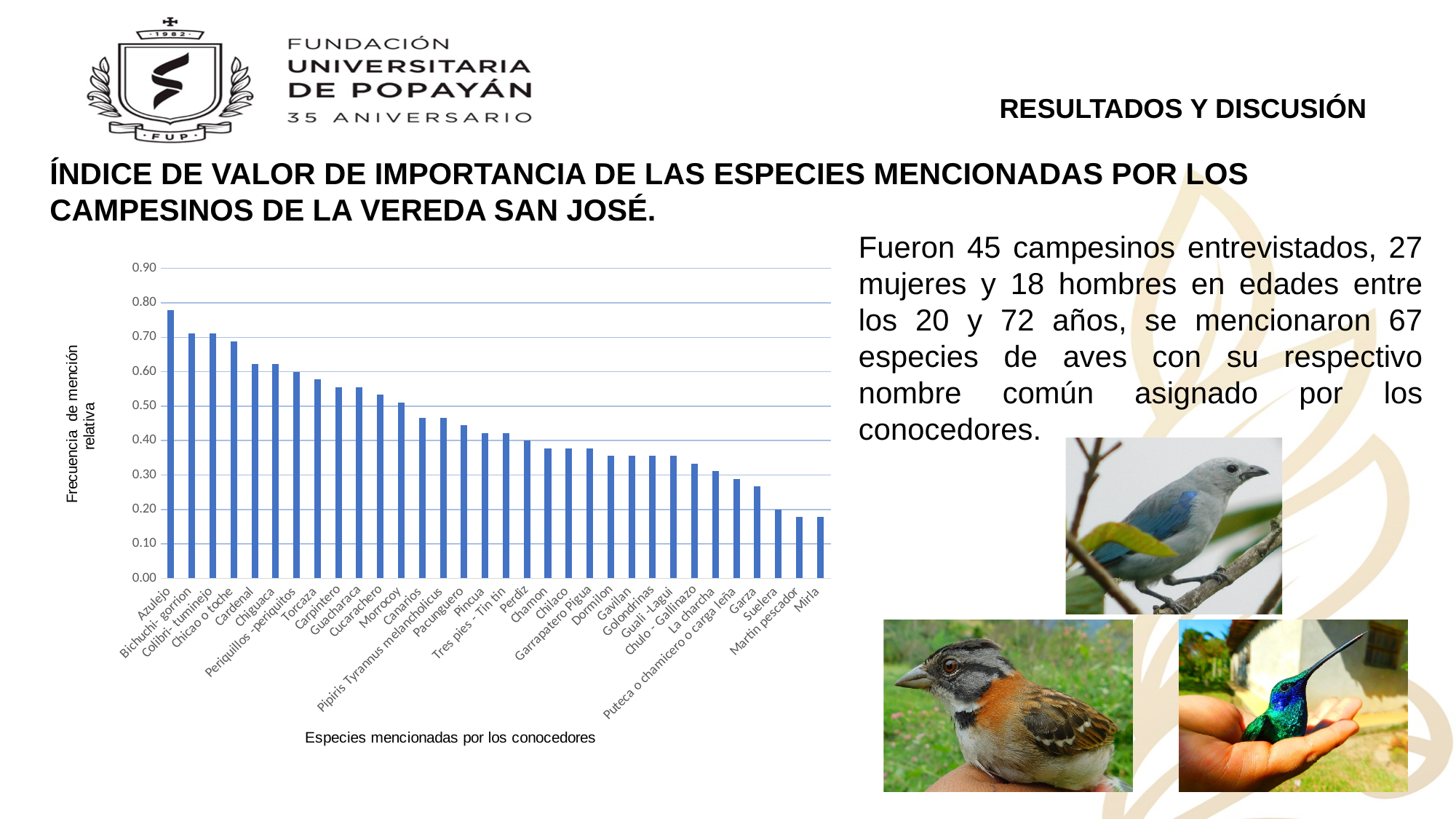
Is the value for Torcaza greater or less than 0.50? greater How many species (categories) are plotted in the chart? 32 What is the title of the y axis of the chart? Frecuencia de mención relativa Is the value for Cucarachero greater or less than 0.50? greater Is the value for Mirla greater or less than 0.20? less Which has a larger value, Chicao o toche or Cardenal? Chicao o toche Do the bar values rise or fall moving from left to right along the x axis? fall Which species has the highest relative mention frequency in the chart? Azulejo What kind of chart is shown on the slide? bar chart Which has a larger value, Torcaza or Garza? Torcaza